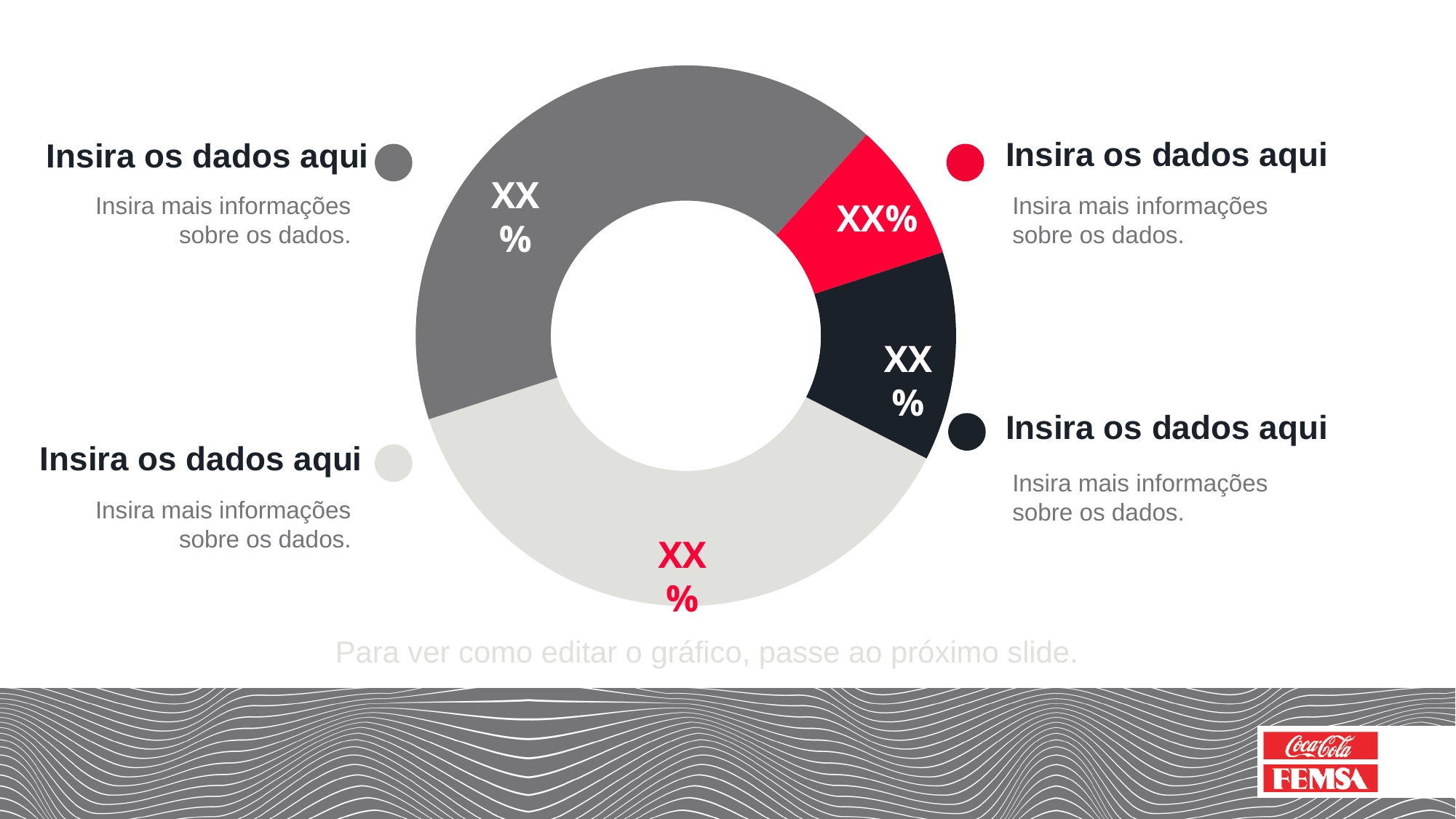
How many slices does the donut chart have? 4 What placeholder text is shown as the data label on each slice of the chart? XX% What placeholder heading is shown next to each coloured legend dot around the chart? Insira os dados aqui What kind of chart is shown on the slide? donut chart Which slice of the donut chart is the smallest? the red slice Which slice is larger, the red slice or the black slice? the black slice